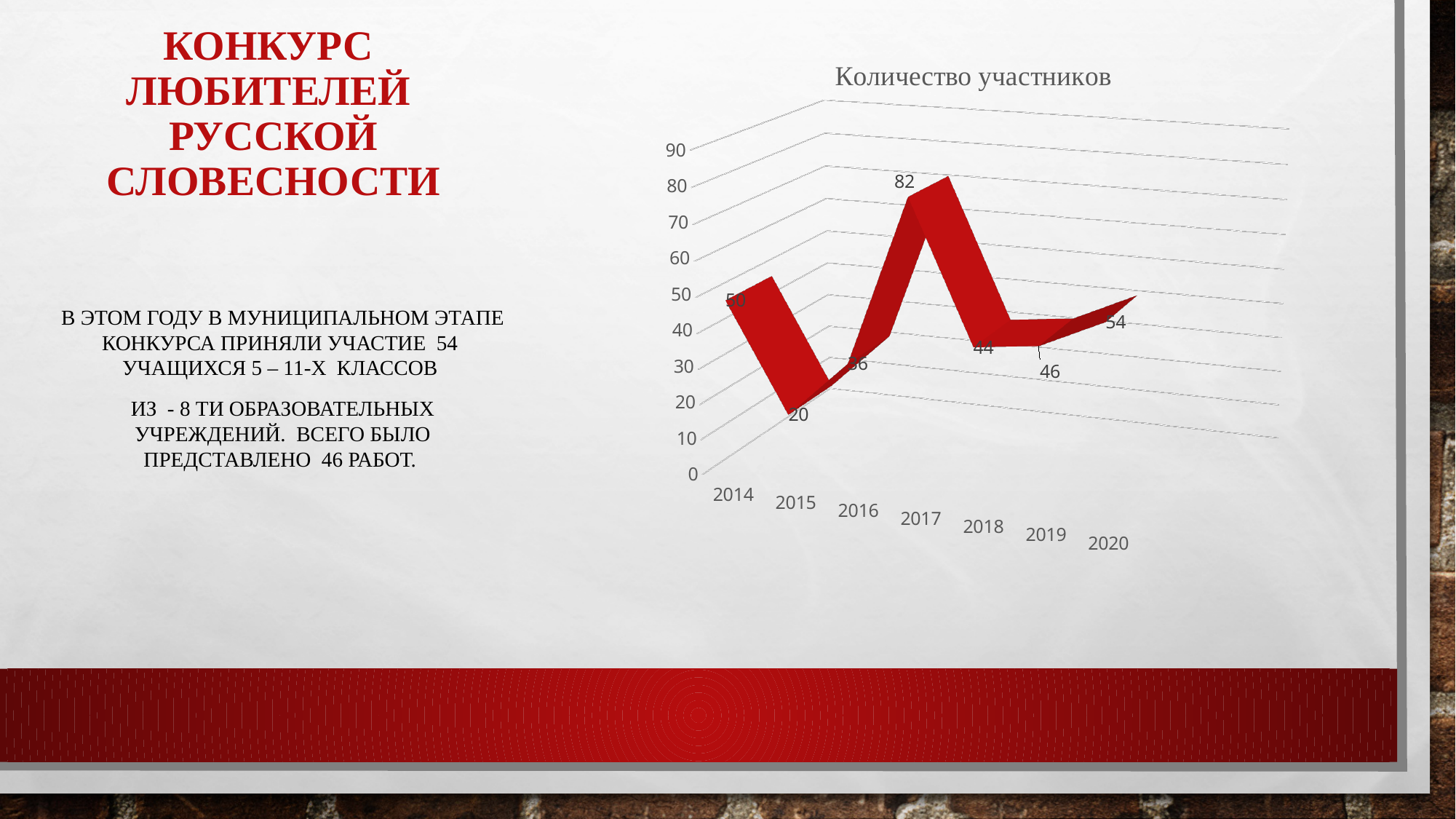
What is the title of the chart? Количество участников What is the number of participants in 2017? 82 Is the value for 2018 greater or less than 50? less How many years are shown on the x axis of the chart? 7 Which year has the lowest number of participants? 2015 Which year has the highest number of participants? 2017 What kind of chart is shown on the slide? line chart What is the number of participants in 2020? 54 What is the difference between the number of participants in 2017 and in 2015? 62 What is the number of participants in 2014? 50 Which year had more participants, 2014 or 2020? 2020 What is the number of participants in 2015? 20